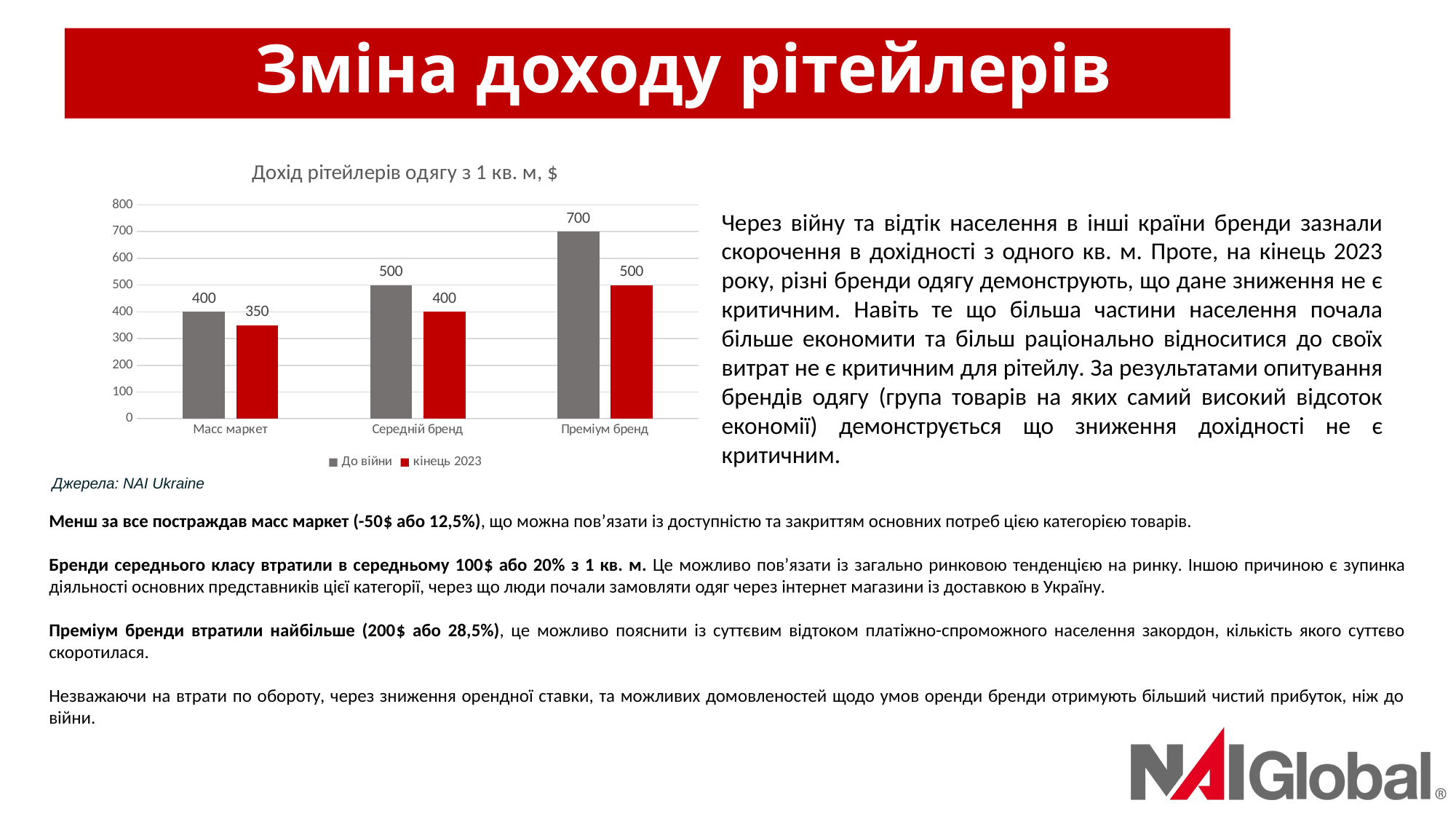
How many categories are shown on the x axis? 3 Which category has the highest value in the До війни series? Преміум бренд Which is larger for Середній бренд: the До війни value or the кінець 2023 value? До війни What is the difference between the До війни and кінець 2023 values for Середній бренд? 100 What is the title of the chart? Дохід рітейлерів одягу з 1 кв. м, $ What is the value for Масс маркет in the До війни series? 400 What kind of chart is shown on the slide? Bar chart What is the difference between the До війни and кінець 2023 values for Преміум бренд? 200 What is the value for Масс маркет in the кінець 2023 series? 350 What is the value for Преміум бренд in the кінець 2023 series? 500 How many series does the legend list? 2 Which category has the lowest value in the кінець 2023 series? Масс маркет